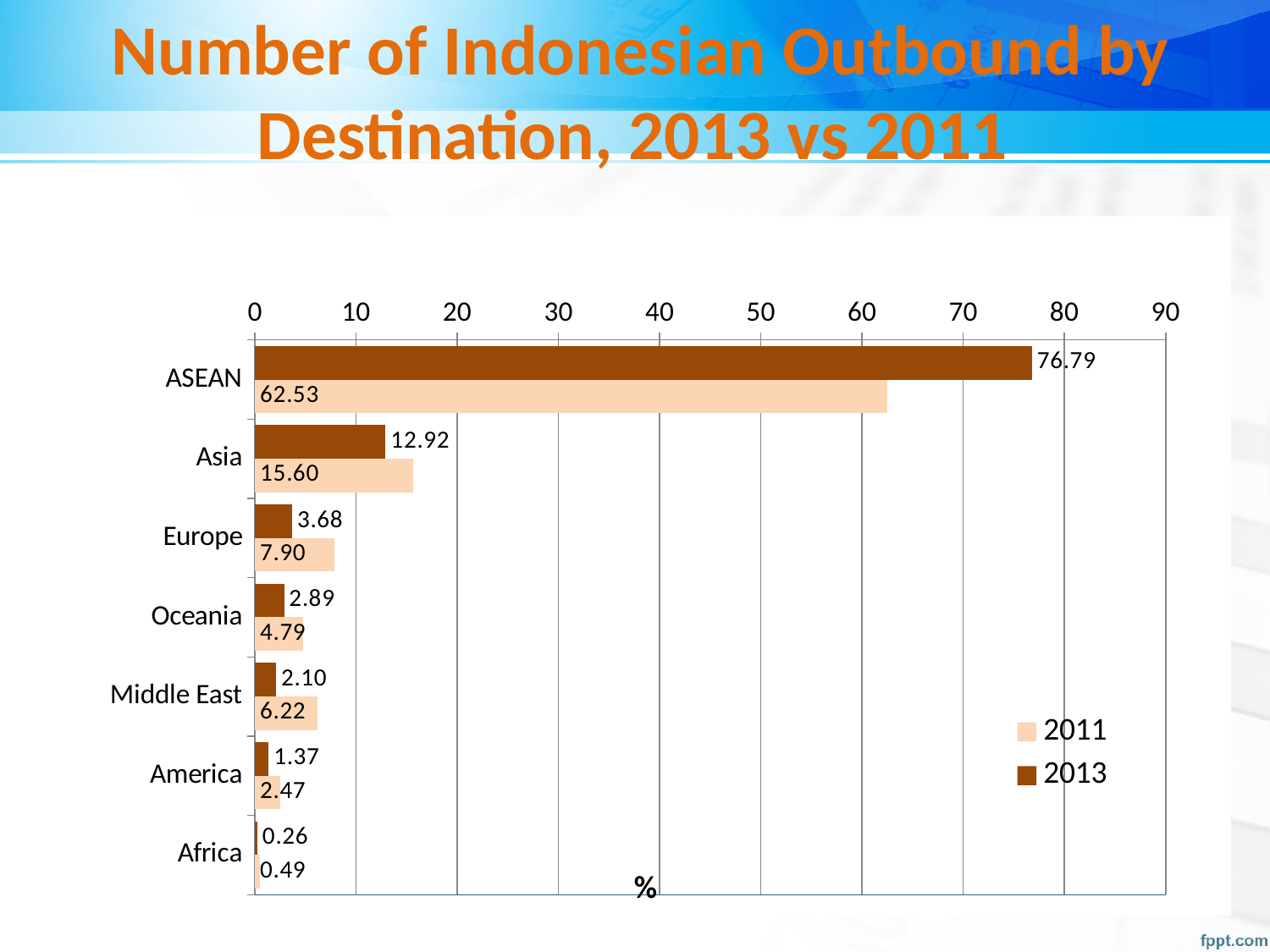
Is the 2011 value for ASEAN greater or less than 60? greater What is the 2011 value for Middle East? 6.22 Which destination has the lowest 2011 value? Africa Which destination has the highest 2013 value? ASEAN What is the 2011 value for Asia? 15.60 How many series does the legend list? 2 What is the 2013 value for ASEAN? 76.79 Which series is shown in the darker brown colour? 2013 How many destination categories are shown on the chart? 7 What is the difference between the 2013 and 2011 values for ASEAN? 14.26 What kind of chart is shown on the slide? bar chart Which is larger for Europe, the 2011 value or the 2013 value? 2011